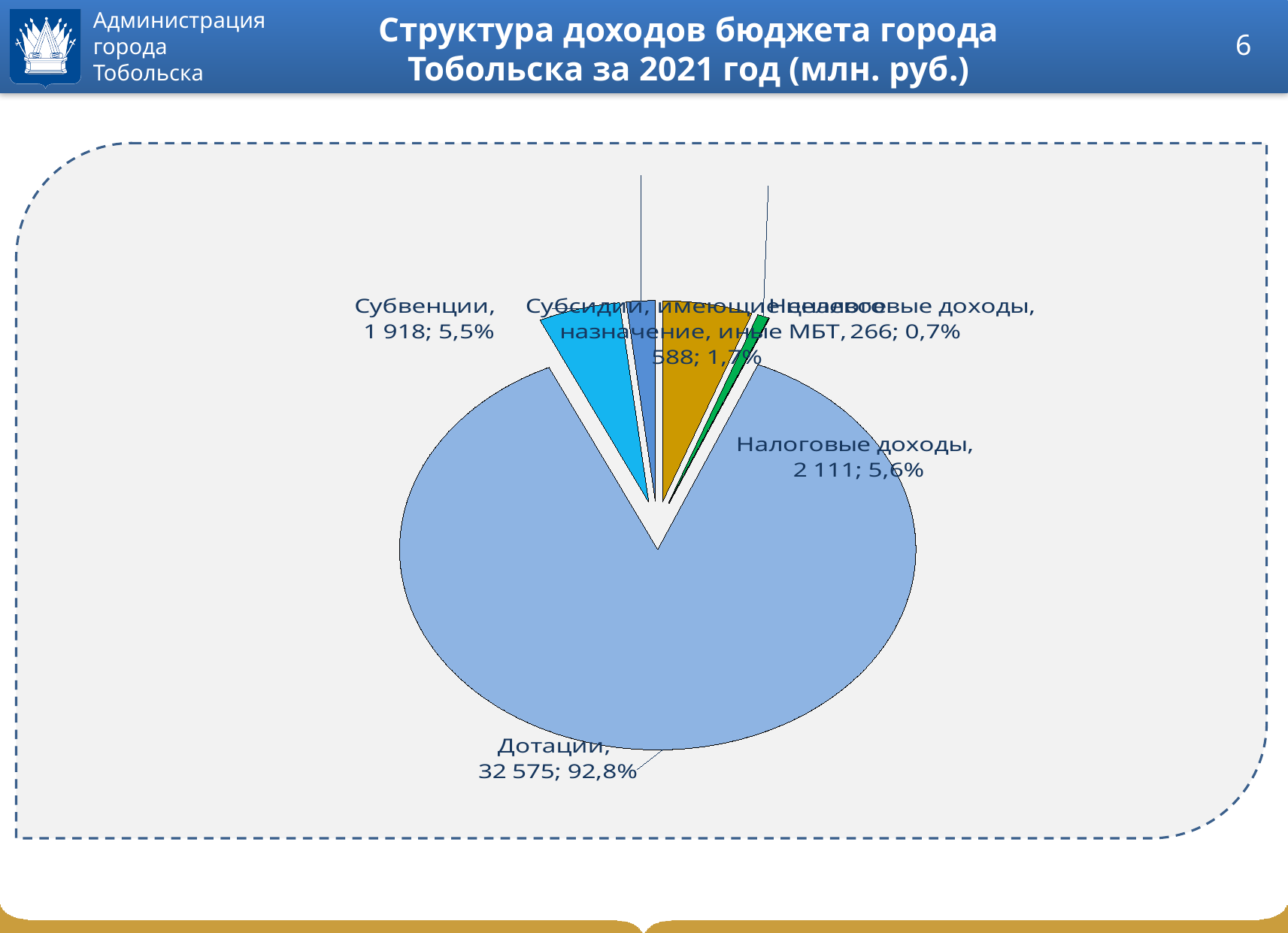
What kind of chart is shown on the slide? pie chart What percentage share is shown for Субсидии, имеющие целевое назначение, иные МБТ? 1,7% Which is larger, Налоговые доходы or Неналоговые доходы? Налоговые доходы What is the value shown for Неналоговые доходы? 266; 0,7% What is the difference between the values for Налоговые доходы and Субвенции? 193 What is the value shown for Дотации? 32 575; 92,8% What is the value shown for Налоговые доходы? 2 111; 5,6% Which category has the largest slice of the pie? Дотации What is the title of the slide containing the chart? Структура доходов бюджета города Тобольска за 2021 год (млн. руб.) How many slices does the pie chart have? 6 What is the value shown for Субвенции? 1 918; 5,5%